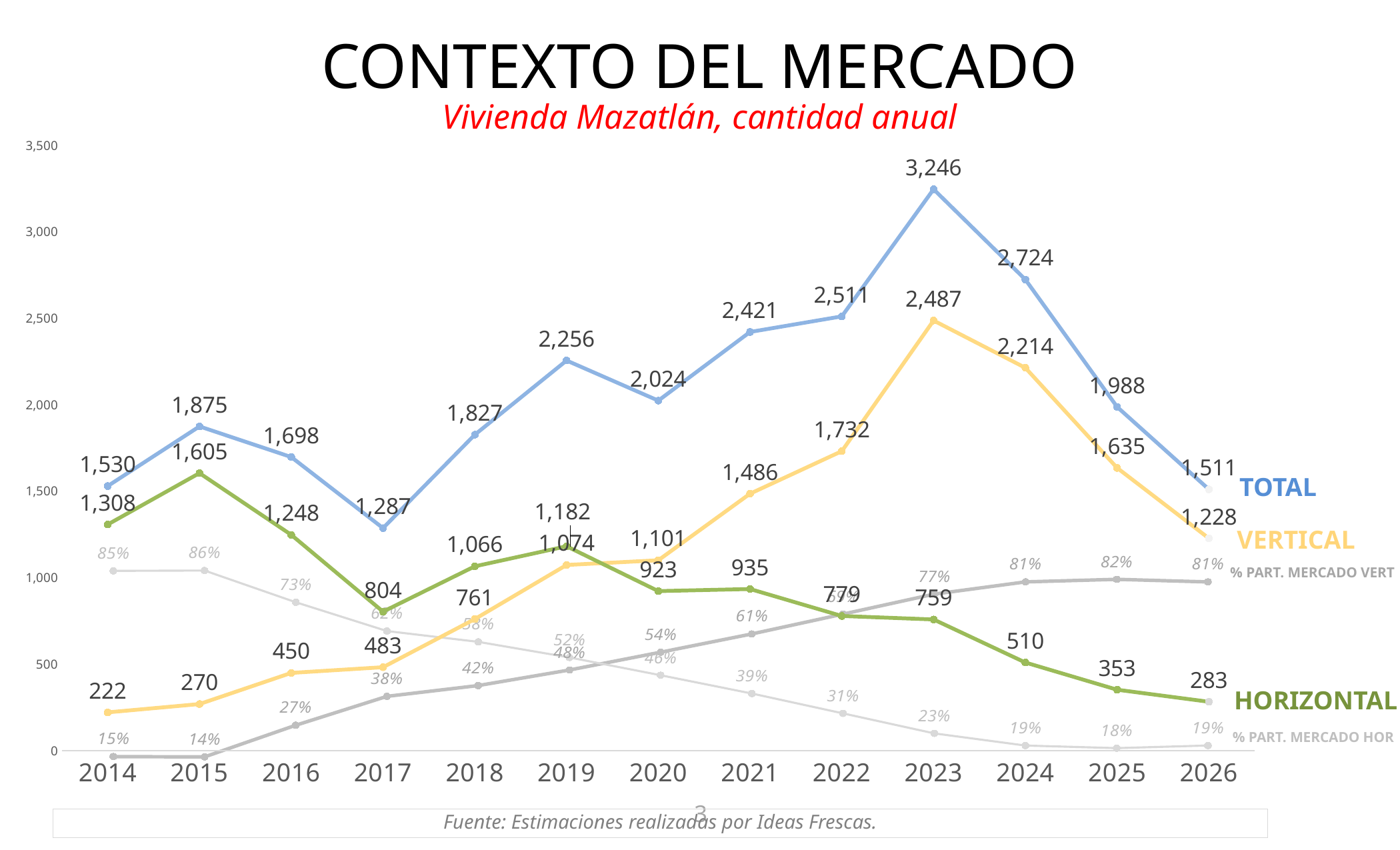
What kind of chart is shown on the slide? line chart What is the subtitle of the chart shown in red? Vivienda Mazatlán, cantidad anual In which year is the VERTICAL series at its lowest value? 2014 What is the difference between the TOTAL values for 2023 and 2024? 522 Does the HORIZONTAL series rise or fall from 2023 to 2026? fall Is the TOTAL value for 2017 greater or less than 1,500? less What is the VERTICAL value for 2019? 1,074 What is the TOTAL value for 2023? 3,246 In which year does the TOTAL series reach its highest value? 2023 What is the HORIZONTAL value for 2026? 283 How many years are shown on the x axis? 13 Which is larger in 2019, the VERTICAL value or the HORIZONTAL value? HORIZONTAL